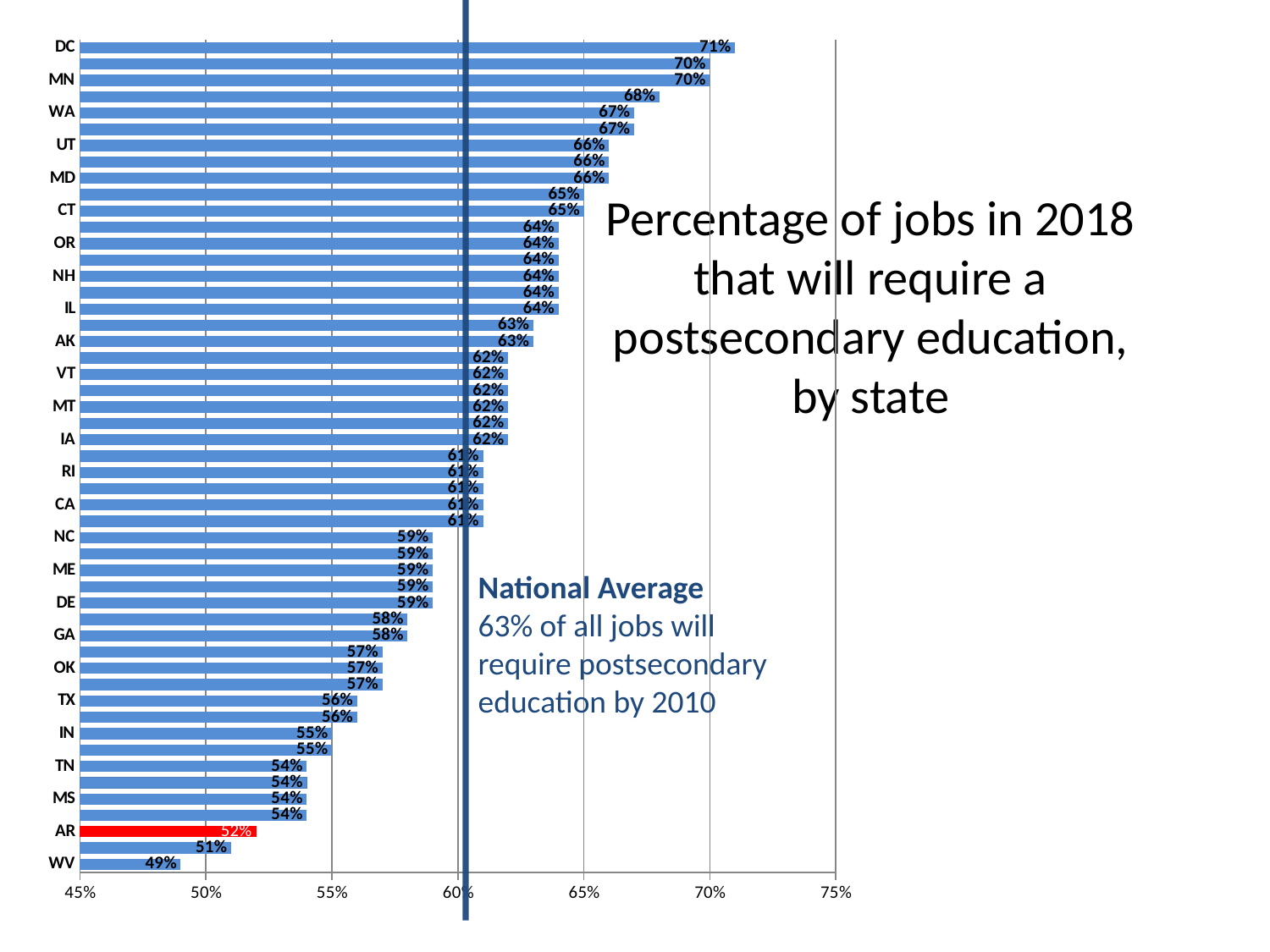
Which state has the lowest percentage? WV Which state's bar is coloured red? AR What is the title of the chart? Percentage of jobs in 2018 that will require a postsecondary education, by state What is the value for AR? 52% What is the value for WV? 49% What kind of chart is shown on the slide? Bar chart Which is larger, the value for MN or the value for WA? MN What is the value for TX? 56% What is the value for MN? 70% Which state has the highest percentage? DC What is the difference between the values for DC and WV? 22 percentage points What is the value for DC? 71%